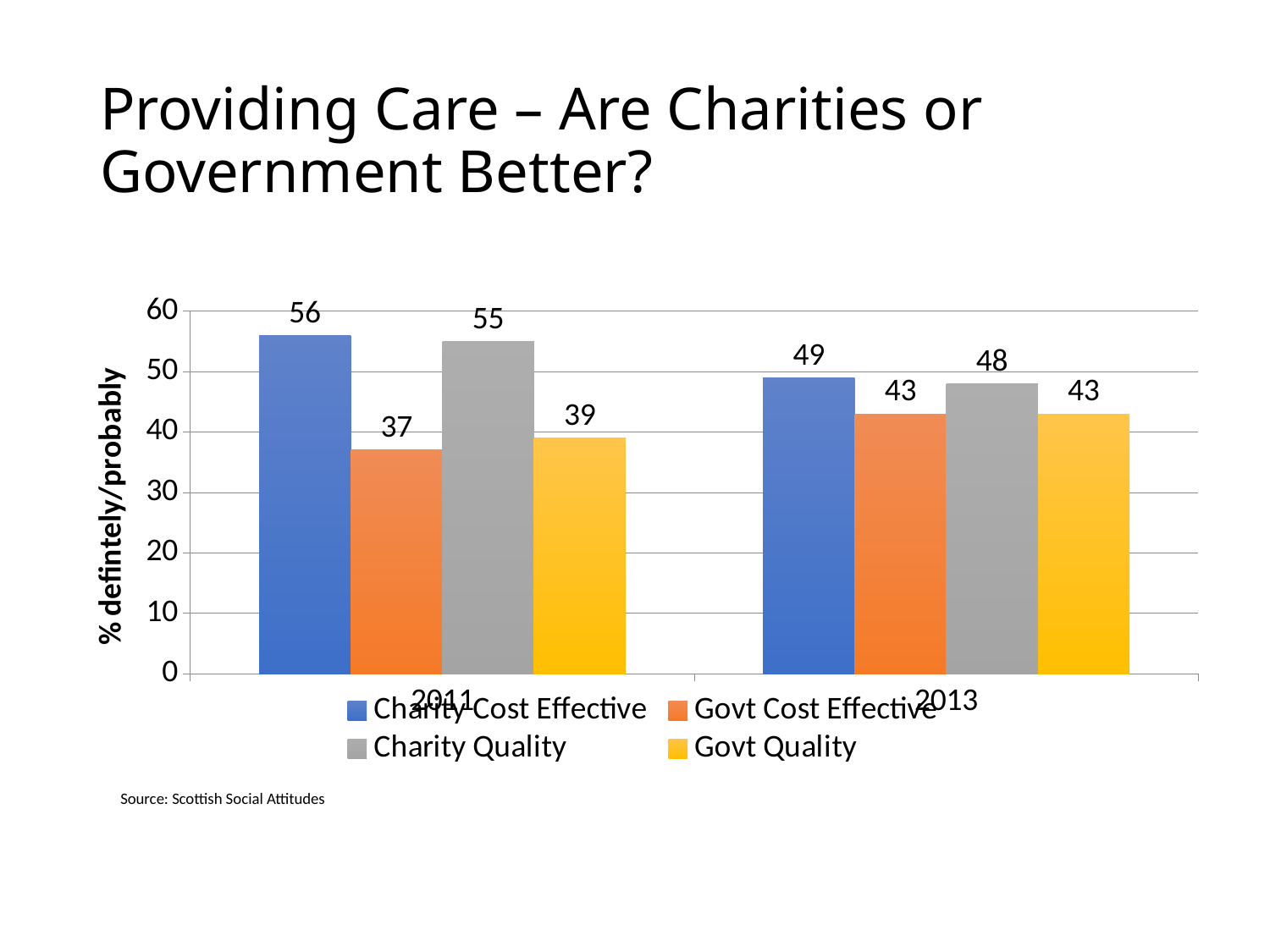
What kind of chart is shown on the slide? Bar chart What is the difference between Charity Quality and Govt Quality in 2011? 16 What is the value for Govt Quality in 2013? 43 What is the value for Govt Cost Effective in 2011? 37 How many year categories are shown on the x axis? 2 Which series has the lowest value in 2011? Govt Cost Effective What is the difference between Charity Cost Effective in 2011 and in 2013? 7 Does the value for Govt Cost Effective rise or fall from 2011 to 2013? Rise How many series does the legend list? 4 Which series has the highest value in 2011? Charity Cost Effective What is the value for Charity Cost Effective in 2011? 56 Which is larger in 2013, Charity Cost Effective or Govt Cost Effective? Charity Cost Effective